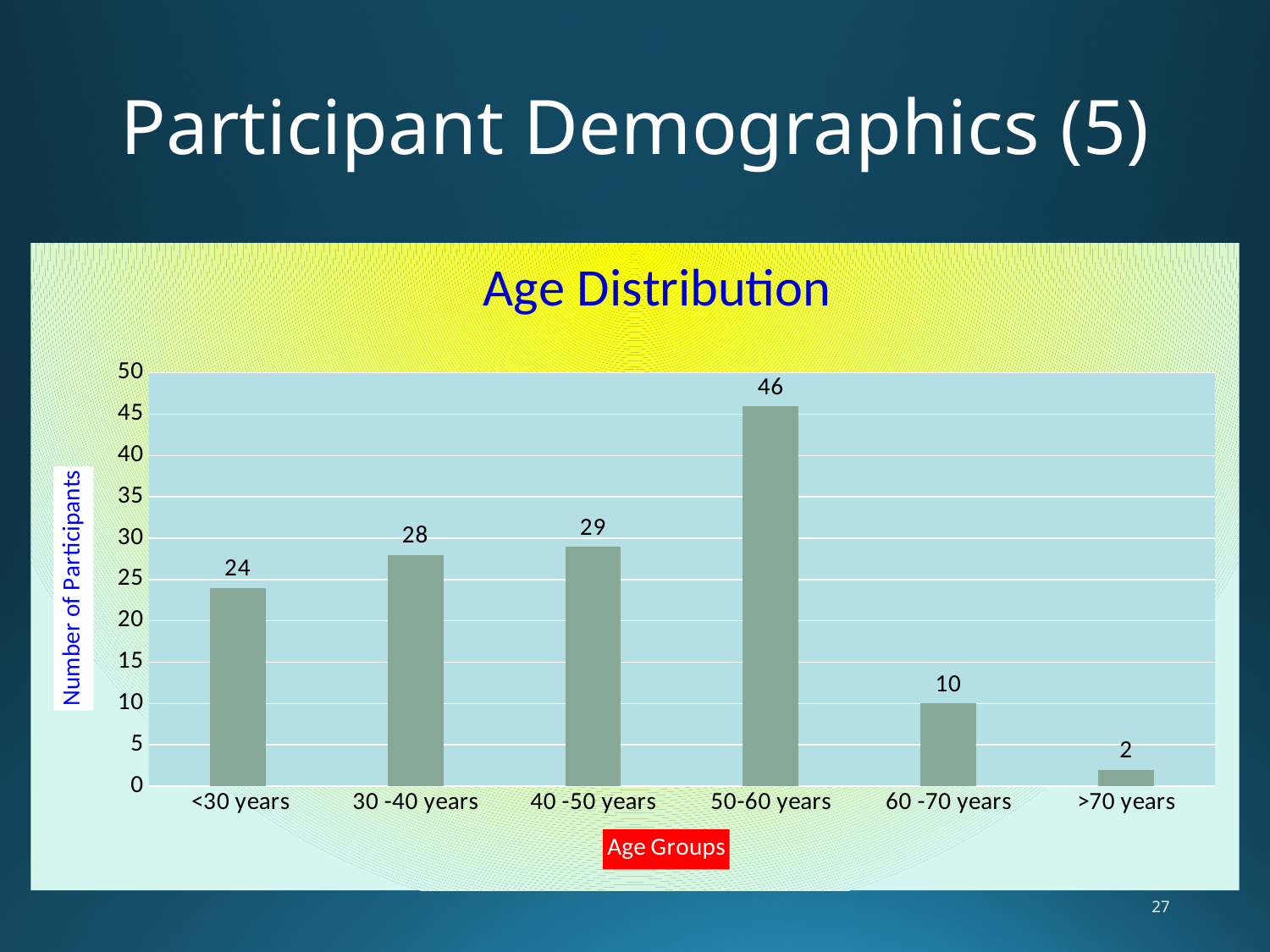
What kind of chart is shown on the slide? bar chart What is the label of the vertical axis? Number of Participants Which age group has more participants, 30 -40 years or 40 -50 years? 40 -50 years What is the number of participants in the 50-60 years age group? 46 Which age group has the highest number of participants? 50-60 years How many age groups are shown on the chart? 6 What is the title of the chart? Age Distribution What is the number of participants in the <30 years age group? 24 What is the difference in number of participants between the 50-60 years and 60 -70 years age groups? 36 Is the value for the 60 -70 years age group greater or less than 15? less Which age group has the lowest number of participants? >70 years What is the number of participants in the >70 years age group? 2